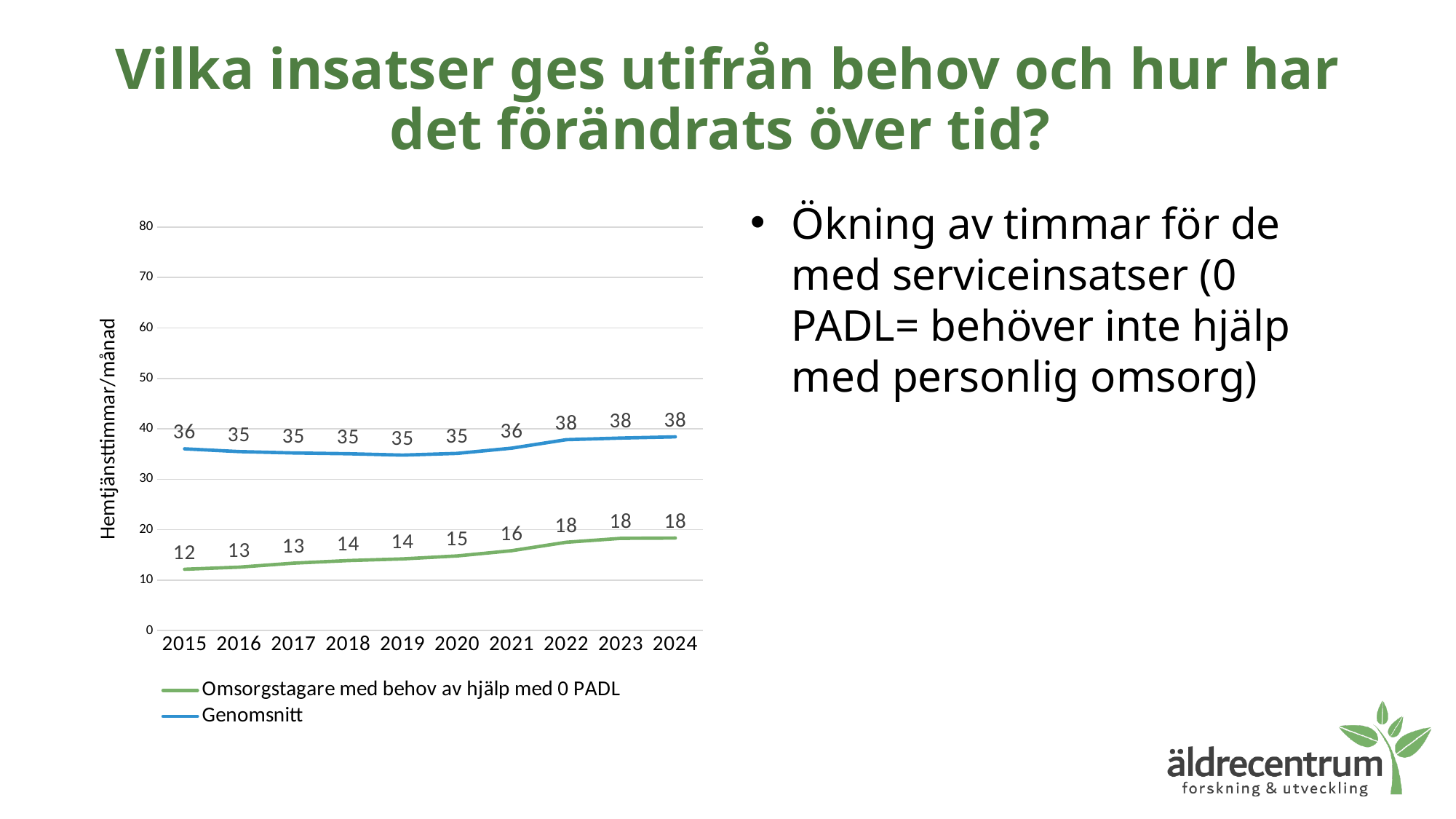
Does the 'Omsorgstagare med behov av hjälp med 0 PADL' series rise or fall from 2015 to 2024? rise What is the value for 'Genomsnitt' in 2024? 38 By how much did the value for 'Omsorgstagare med behov av hjälp med 0 PADL' increase from 2015 to 2024? 6 What is the value for 'Genomsnitt' in 2019? 35 What is the label of the y axis? Hemtjänsttimmar/månad How many years are shown on the x axis? 10 How many series does the legend list? 2 What is the value for 'Omsorgstagare med behov av hjälp med 0 PADL' in 2015? 12 What is the difference between the 'Genomsnitt' value and the 'Omsorgstagare med behov av hjälp med 0 PADL' value in 2024? 20 In which year is the value for 'Omsorgstagare med behov av hjälp med 0 PADL' lowest? 2015 What kind of chart is shown on the slide? line chart What is the value for 'Omsorgstagare med behov av hjälp med 0 PADL' in 2021? 16